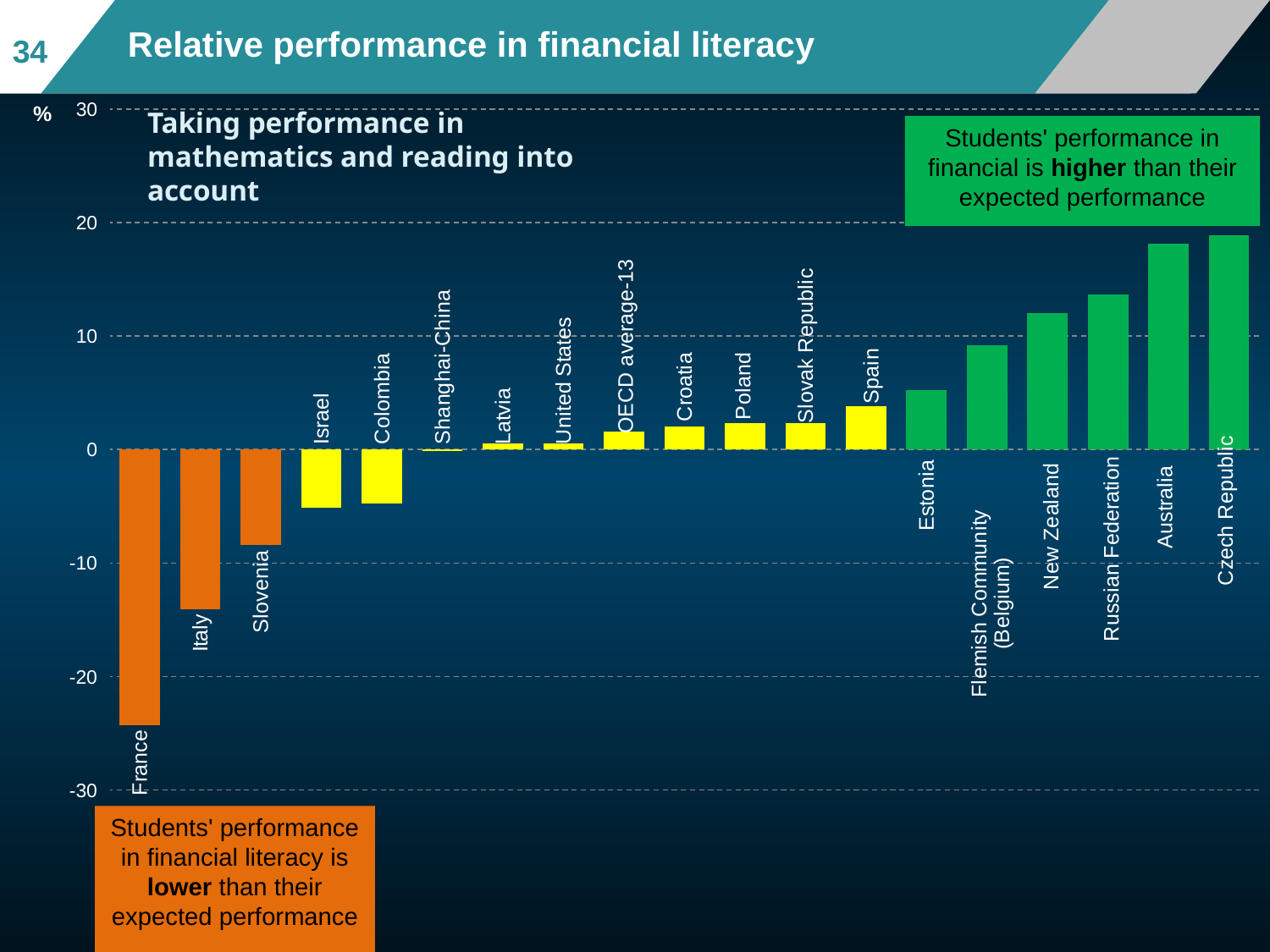
Which category has the highest value in the chart? Czech Republic Is the value for France greater or less than -20? less Is the value for Slovenia greater or less than -10? greater Is the value for Australia greater or less than 10? greater What kind of chart is shown on the slide? bar chart Do the values rise or fall moving from left to right along the x axis? rise Which category has the lowest value in the chart? France Which has the larger value, Russian Federation or New Zealand? Russian Federation How many countries/economies (categories) are plotted in the chart? 19 What colour are the bars for countries whose students perform higher in financial literacy than expected? green